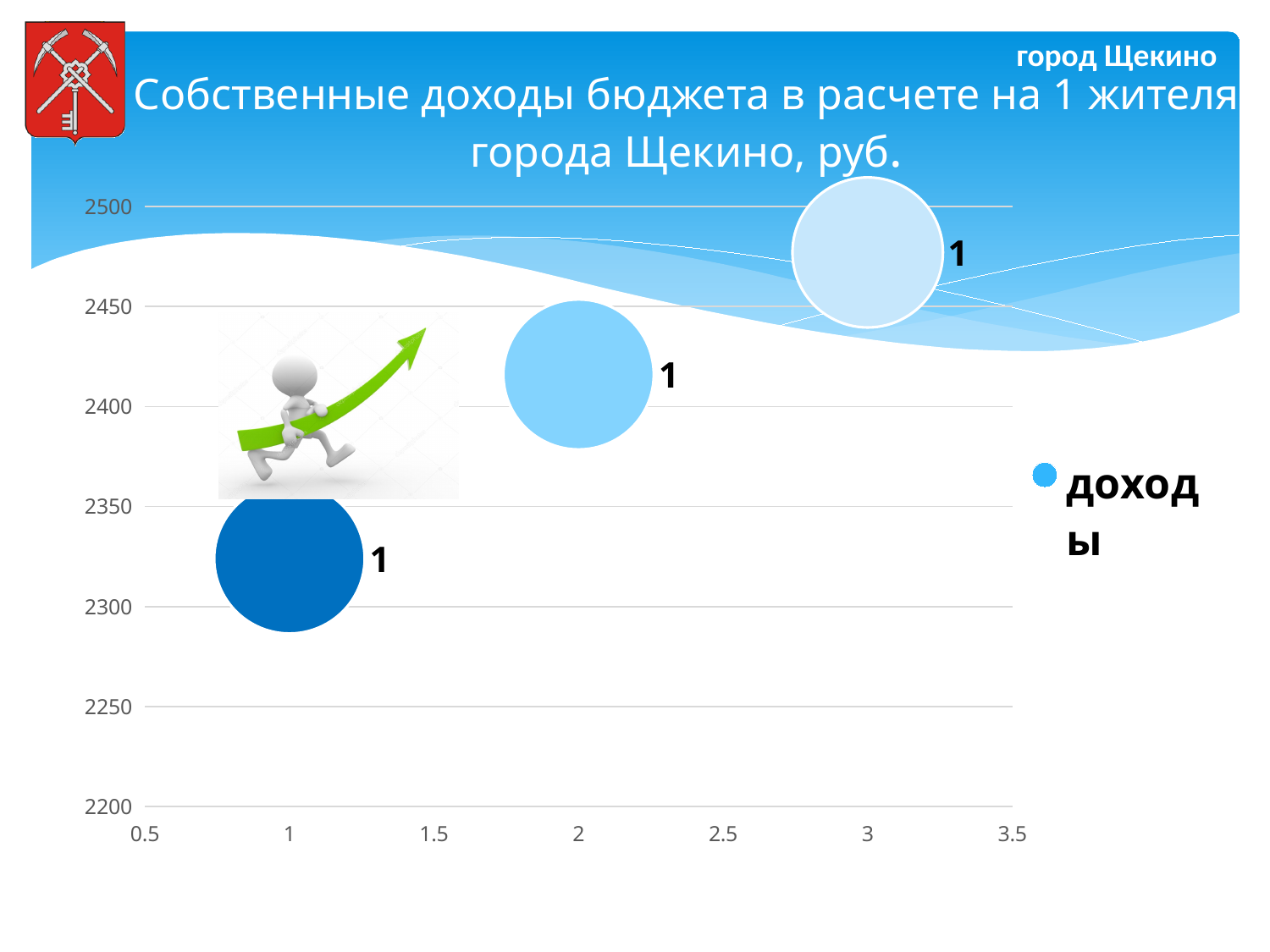
Is the value for the bubble at x = 1 greater or less than 2300? greater Is the value for the bubble at x = 2 greater or less than 2400? greater What is the name of the series shown in the legend? доходы Do the values rise or fall as the x axis goes from 1 to 3? rise How many series does the chart legend list? 1 At which x-axis position is the lowest value plotted? 1 What kind of chart is shown on the slide? bubble chart At which x-axis position is the highest value plotted? 3 What is the title of the chart? Собственные доходы бюджета в расчете на 1 жителя города Щекино, руб. How many data points (bubbles) are plotted on the chart? 3 Is the value for the bubble at x = 3 greater or less than 2500? less Which is larger, the value at x = 2 or the value at x = 1? x = 2